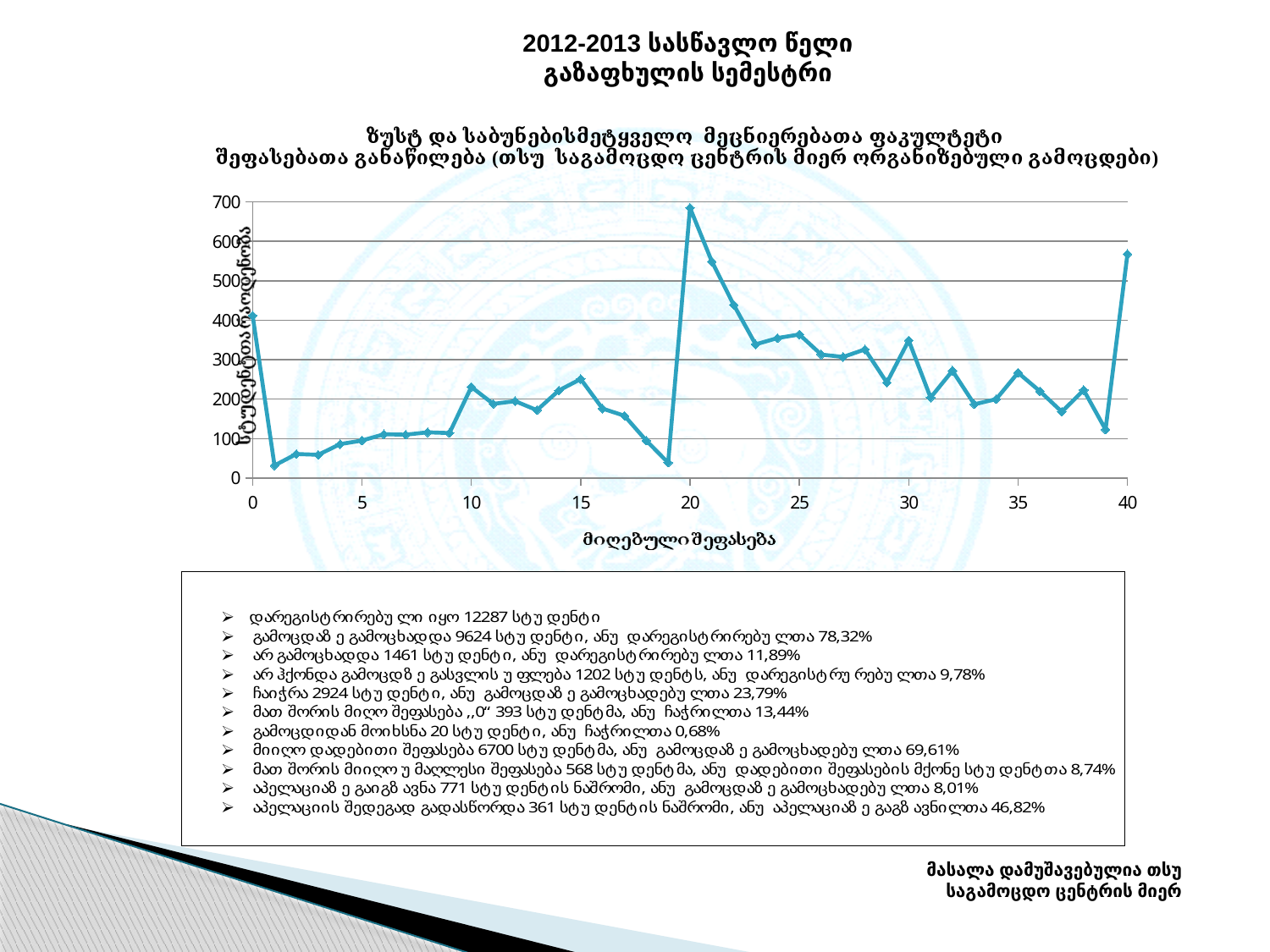
At which x-axis value (მიღებული შეფასება) does the line reach its highest point? 20 What is the highest tick value shown on the y axis? 700 Is the value at x = 20 greater or less than 600? greater Is the value at x = 19 greater or less than 100? less Do the values rise or fall along the x axis from x = 20 to x = 23? fall Which is larger, the value at x = 20 or the value at x = 40? x = 20 What kind of chart is shown on the slide? line chart Is the value at x = 40 greater or less than 500? greater Which is larger, the value at x = 0 or the value at x = 10? x = 0